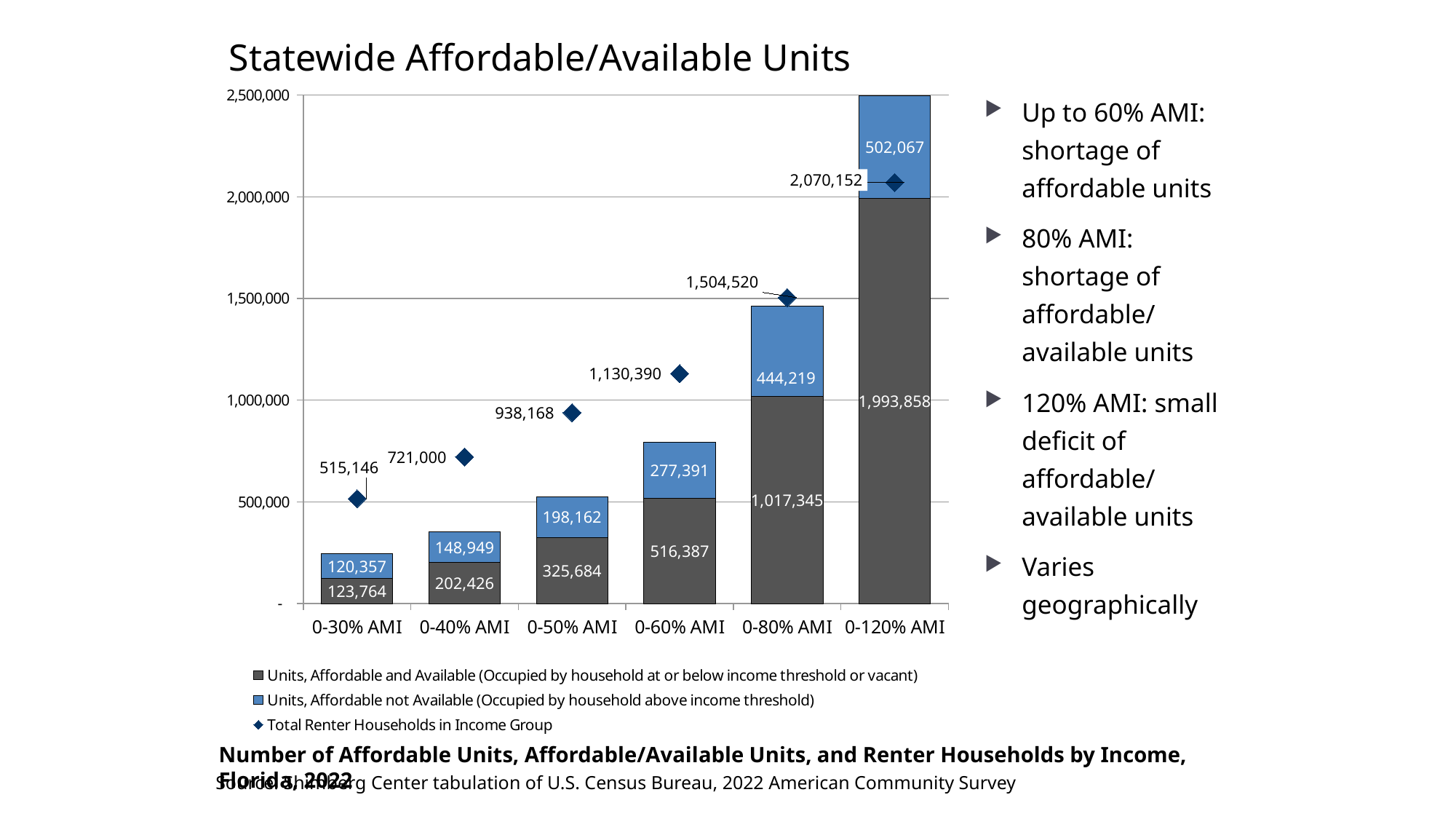
What is the total height of the stacked bar for 0-30% AMI? 244,121 What is the value of Units, Affordable not Available for 0-80% AMI? 444,219 What is the value of Units, Affordable and Available for 0-60% AMI? 516,387 Which income group has the lowest value for Units, Affordable and Available? 0-30% AMI Do the Total Renter Households values rise or fall from 0-30% AMI to 0-120% AMI? rise How many income group categories are shown on the x axis? 6 What is the difference between the Total Renter Households values for 0-120% AMI and 0-80% AMI? 565,632 Which income group has the highest Total Renter Households in Income Group value? 0-120% AMI What is the total height of the stacked bar for 0-80% AMI? 1,461,564 Which is larger: Units, Affordable not Available for 0-40% AMI or Units, Affordable and Available for 0-40% AMI? Units, Affordable and Available How many series does the legend list? 3 What is the Total Renter Households in Income Group value for 0-50% AMI? 938,168